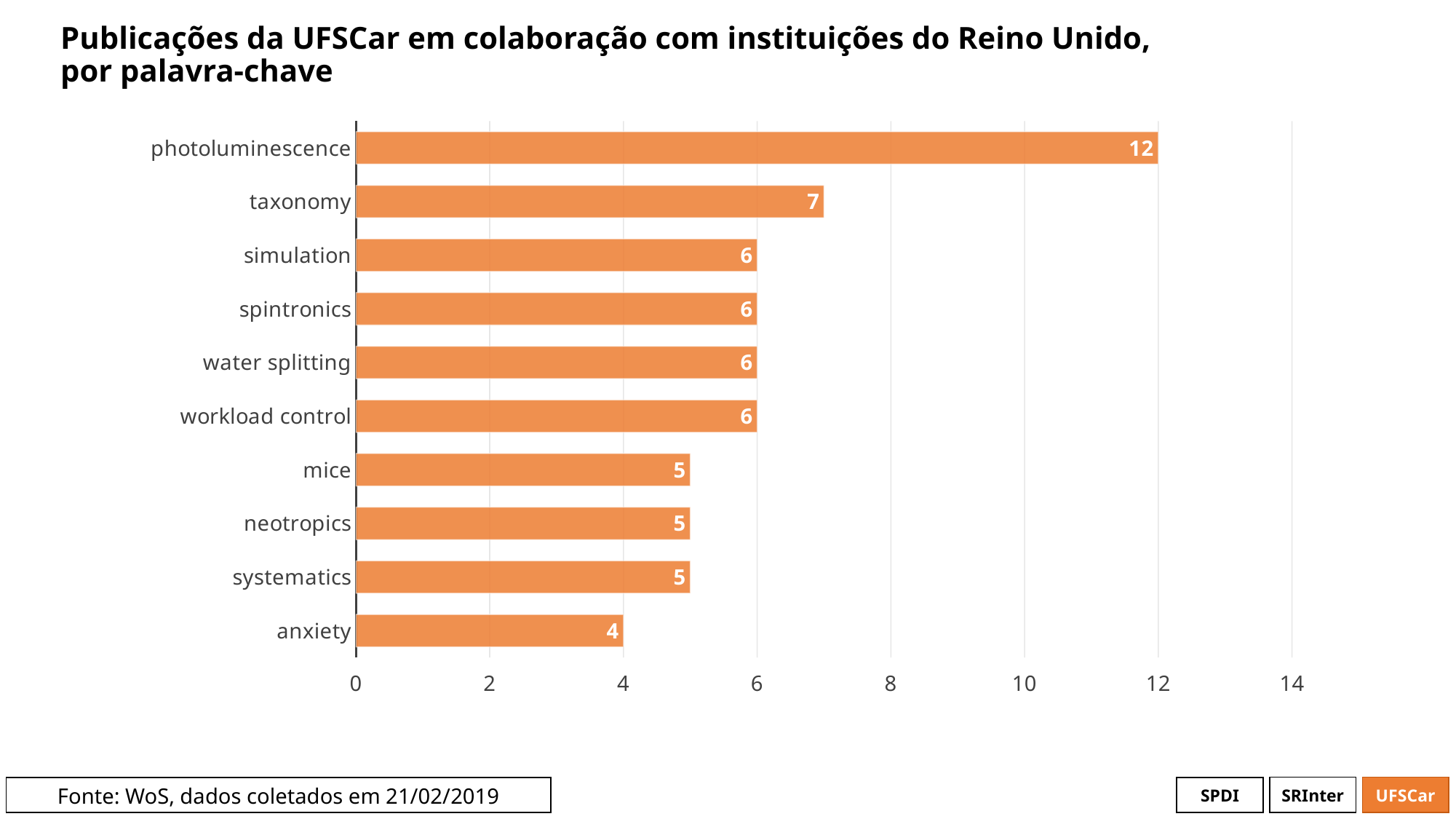
Which keyword has the highest value? photoluminescence What is the difference between the values for photoluminescence and taxonomy? 5 How many keywords are shown in the chart? 10 What is the source of the data cited on the slide? WoS, dados coletados em 21/02/2019 What is the value for anxiety? 4 Which is larger, the value for simulation or the value for neotropics? simulation What is the value for mice? 5 What kind of chart is shown on the slide? bar chart Is the value for photoluminescence greater or less than 10? greater What is the value for photoluminescence? 12 Which keyword has the lowest value? anxiety What is the value for taxonomy? 7